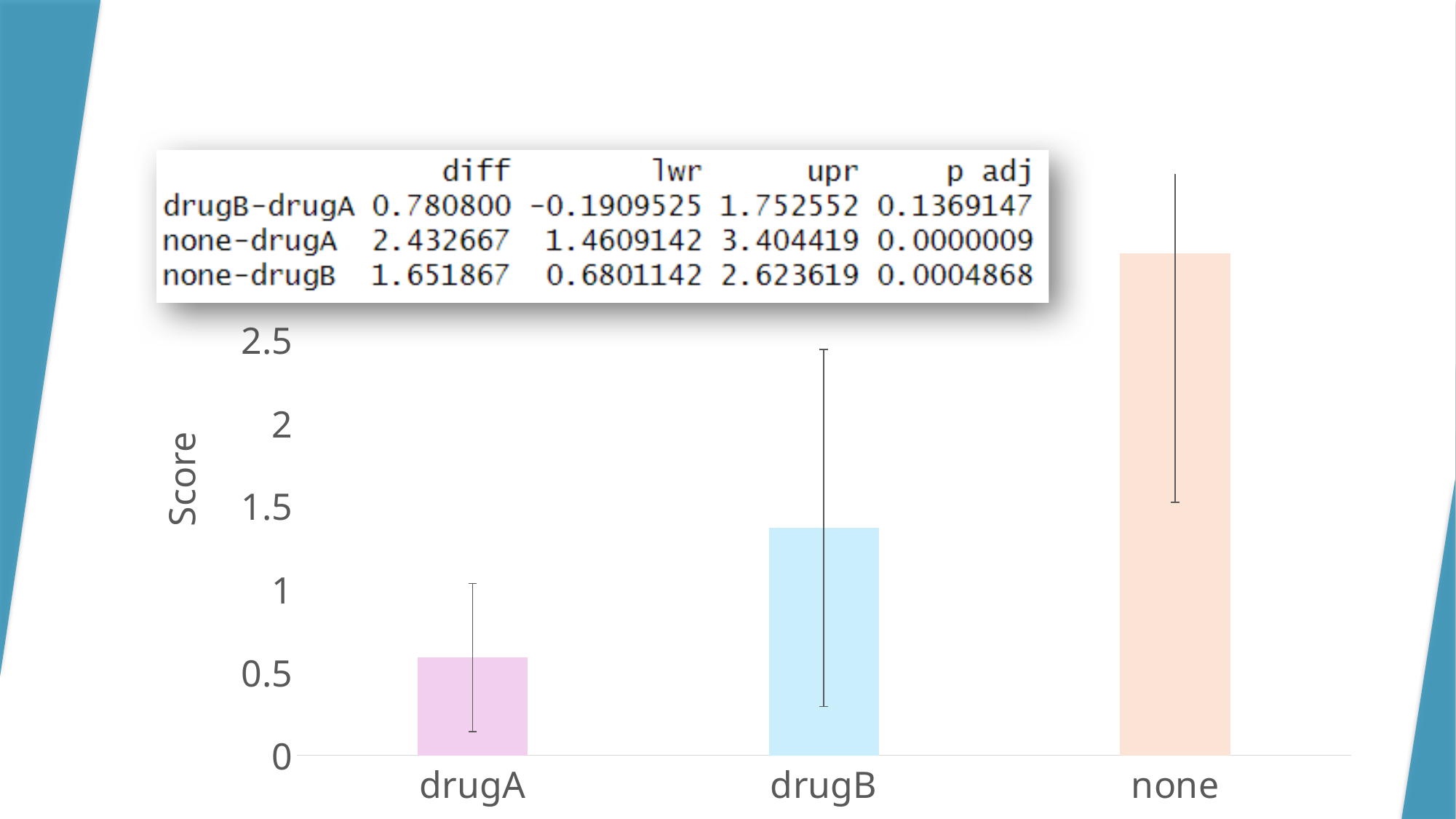
Is the Score for drugA greater or less than 0.5? greater What is the label on the vertical axis of the bar chart? Score How many categories are plotted on the x axis of the bar chart? 3 Which category has the highest Score in the bar chart? none Is the Score for drugA greater or less than 1? less Which has the larger Score, drugA or drugB? drugB Which category has the lowest Score in the bar chart? drugA Is the Score for drugB greater or less than 1? greater Do the bar values rise or fall from drugA to none along the x axis? rise What kind of chart is shown on the slide? bar chart Which has the larger Score, drugB or none? none